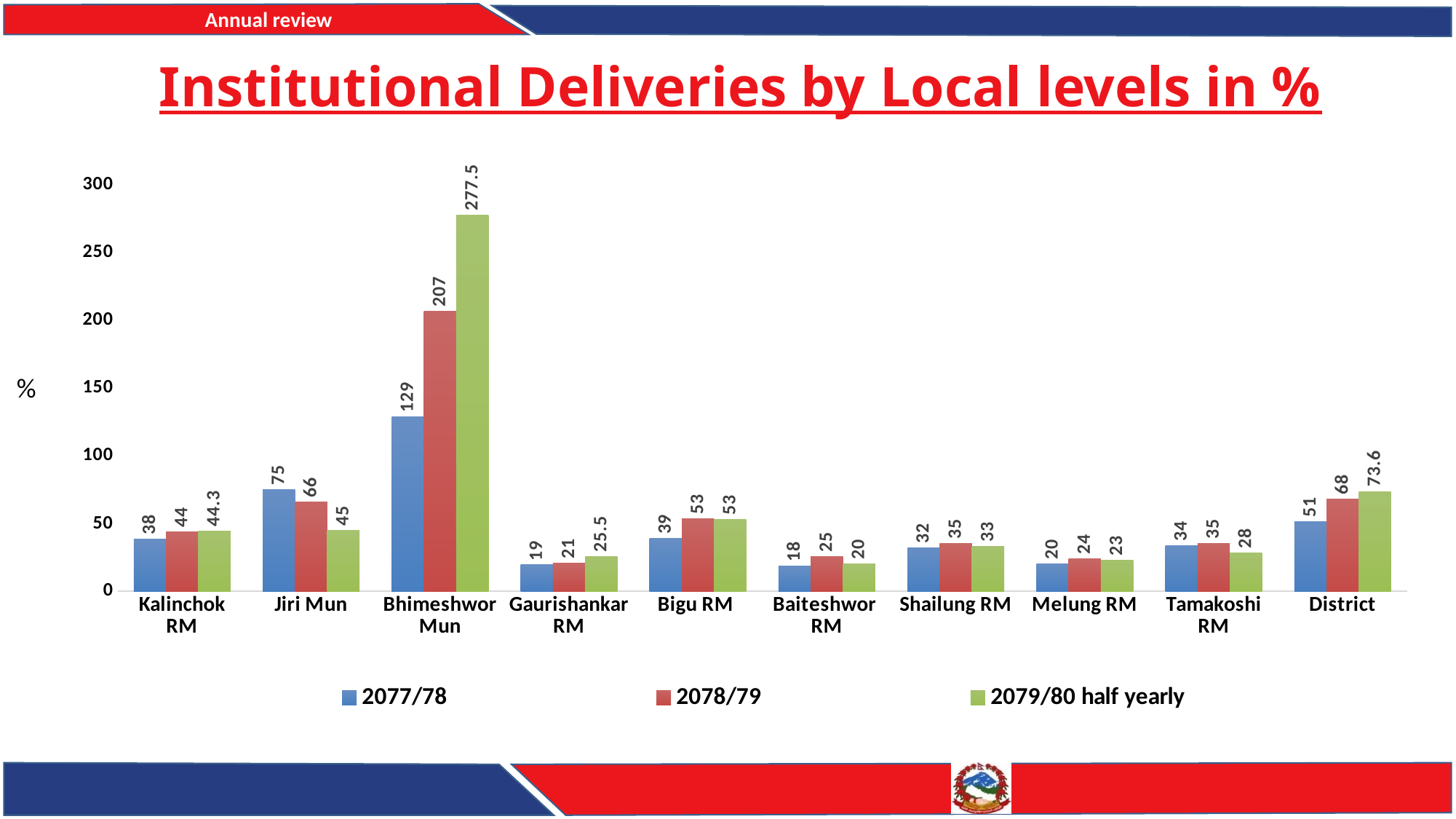
What kind of chart is shown on the slide? Bar chart How many local levels (categories) are shown on the x axis? 10 Which local level has the highest value in the 2078/79 series? Bhimeshwor Mun What is the difference between the 2079/80 half yearly and 2077/78 values for Bhimeshwor Mun? 148.5 What is the value for Bhimeshwor Mun in the 2079/80 half yearly series? 277.5 Is the 2078/79 value for Bhimeshwor Mun greater or less than 200? greater Which is larger for Tamakoshi RM: the 2078/79 value or the 2079/80 half yearly value? 2078/79 What is the value for Jiri Mun in the 2077/78 series? 75 What is the value for District in the 2078/79 series? 68 How many series does the legend list? 3 What is the title of the chart? Institutional Deliveries by Local levels in % Which local level has the lowest value in the 2077/78 series? Baiteshwor RM